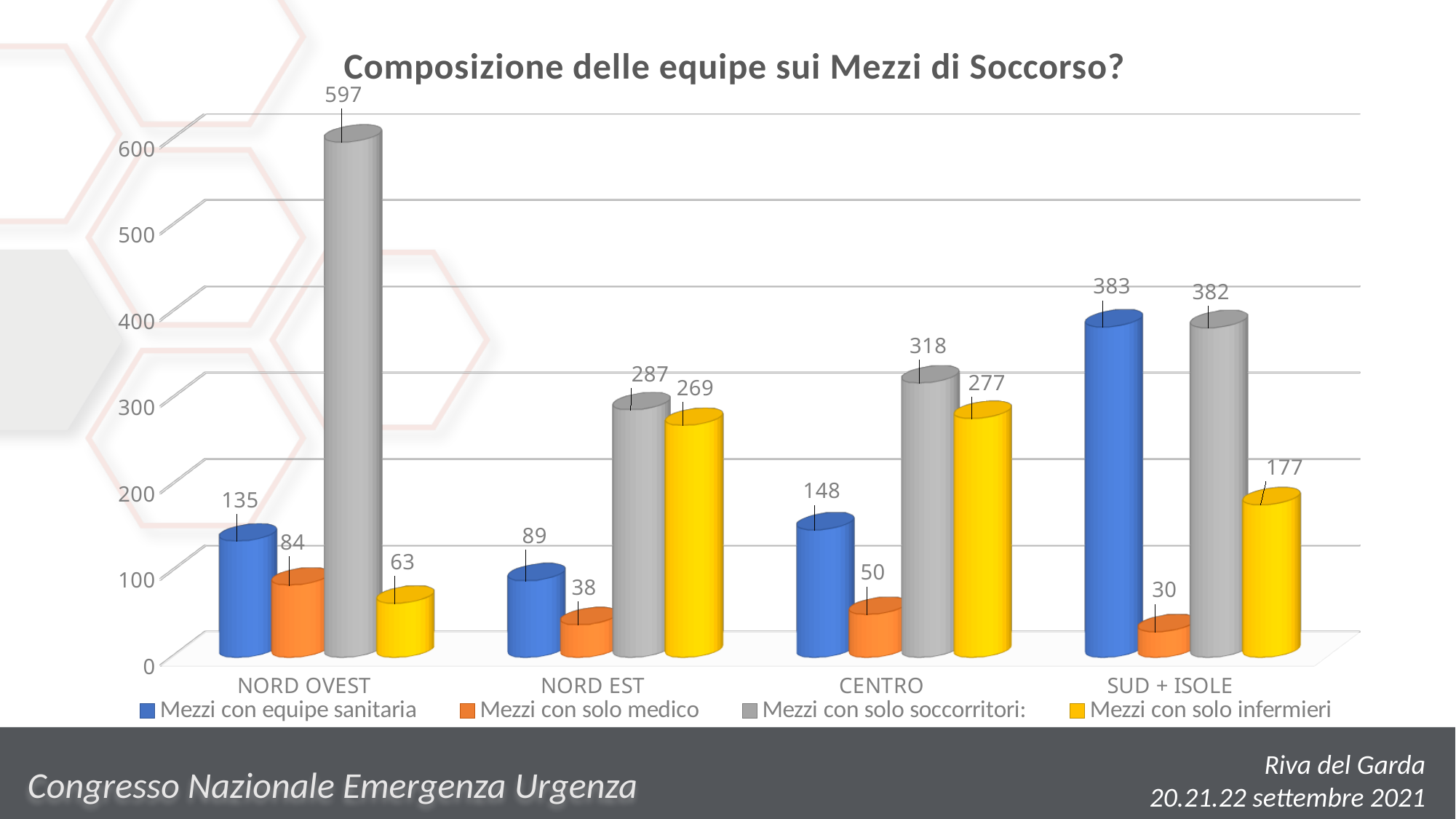
Which is larger in CENTRO: 'Mezzi con equipe sanitaria' or 'Mezzi con solo infermieri'? Mezzi con solo infermieri What is the value for 'Mezzi con solo infermieri' in CENTRO? 277 What is the difference between 'Mezzi con solo soccorritori:' and 'Mezzi con solo infermieri' in NORD EST? 18 What is the title of the chart? Composizione delle equipe sui Mezzi di Soccorso? What is the value for 'Mezzi con solo medico' in NORD EST? 38 Which region has the lowest value for 'Mezzi con solo medico'? SUD + ISOLE What is the value for 'Mezzi con equipe sanitaria' in SUD + ISOLE? 383 What kind of chart is shown on the slide? Bar chart What is the value for 'Mezzi con solo soccorritori:' in NORD OVEST? 597 Which region has the highest value for 'Mezzi con solo soccorritori:'? NORD OVEST How many regions are shown on the x axis? 4 How many series does the legend list? 4